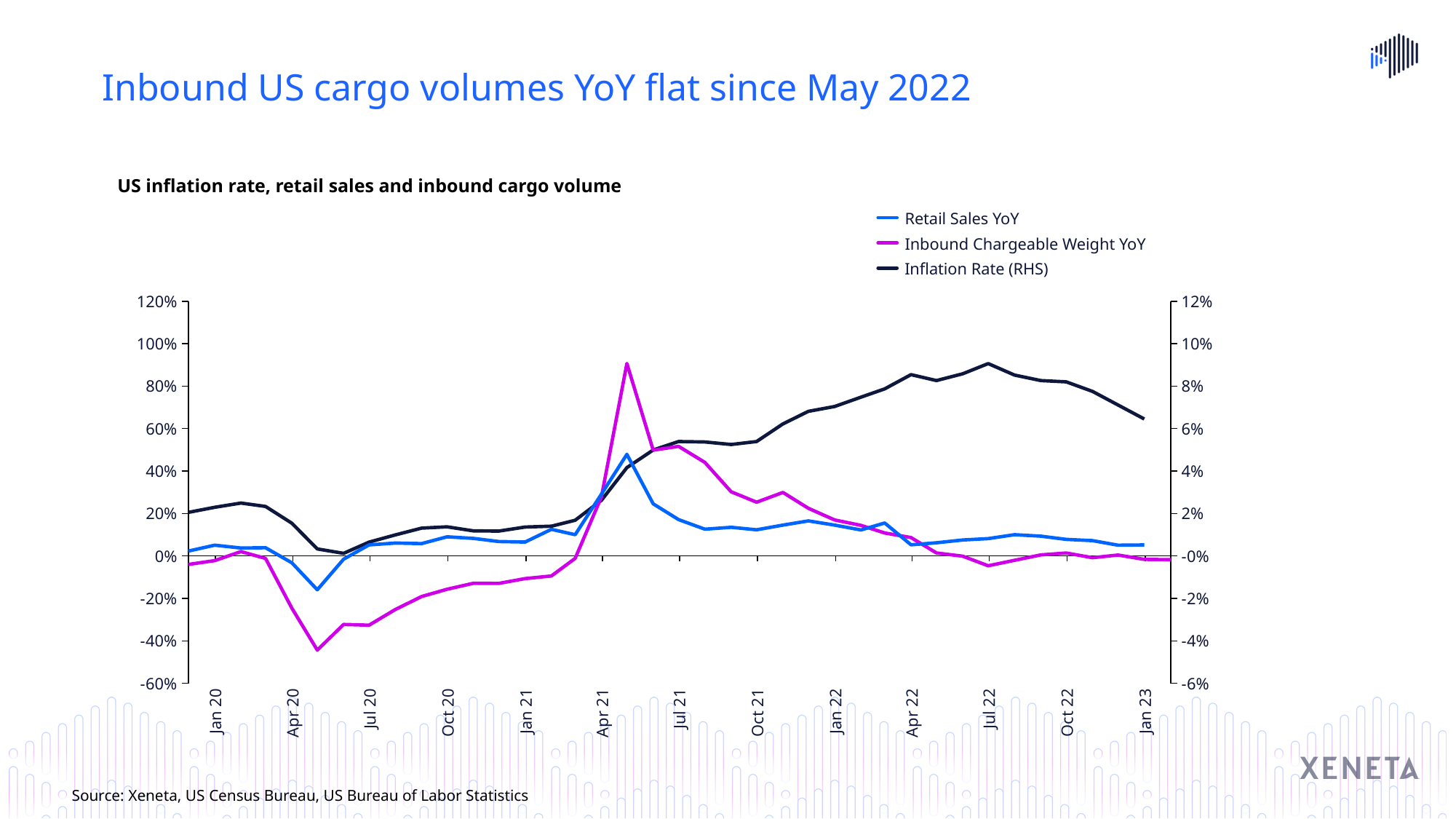
Is the peak of the Inflation Rate (RHS) greater or less than 8%? greater What is the title of the chart? US inflation rate, retail sales and inbound cargo volume Which series reaches the highest point on the left-hand axis? Inbound Chargeable Weight YoY What kind of chart is shown on the slide? Line chart How many series does the legend list? 3 At Jan 23, which is higher: Retail Sales YoY or Inbound Chargeable Weight YoY? Retail Sales YoY Between which two labelled months does Inbound Chargeable Weight YoY reach its peak? Apr 21 and Jul 21 Is the lowest value of Inbound Chargeable Weight YoY greater or less than -40%? less Is the peak value of Retail Sales YoY greater or less than 40%? greater What are the three series listed in the legend? Retail Sales YoY, Inbound Chargeable Weight YoY, Inflation Rate (RHS) Does the Inflation Rate rise or fall between Jul 22 and Jan 23? Fall